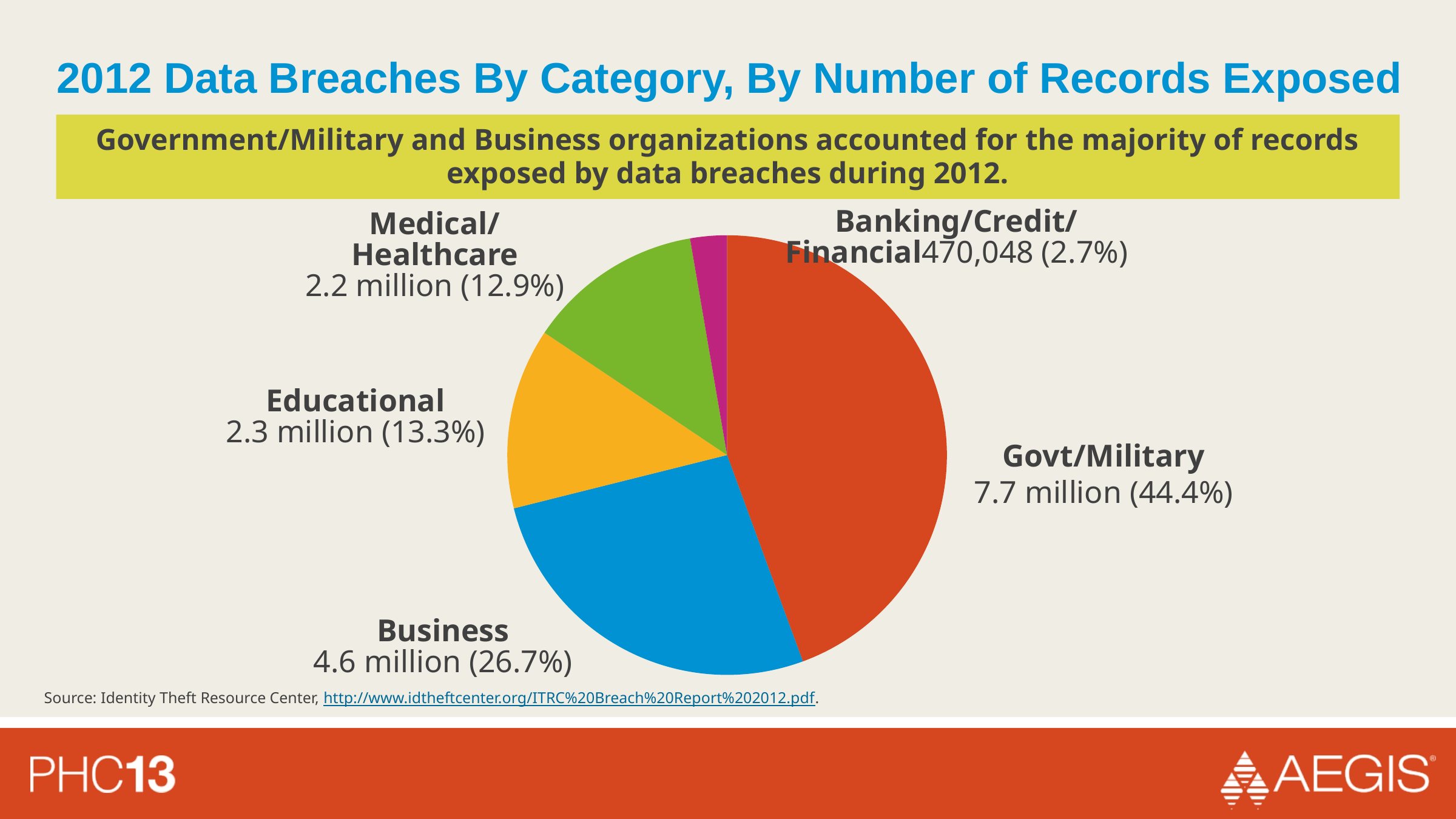
How many categories does the pie chart show? 5 What colour is the Govt/Military slice of the pie chart? Red What share of records exposed is attributed to Govt/Military? 44.4% What percentage of records exposed is attributed to Educational? 13.3% What is the difference in percentage points between the Govt/Military share and the Business share? 17.7 percentage points Which category accounts for the smallest share of records exposed? Banking/Credit/Financial What share of records exposed is attributed to Medical/Healthcare? 12.9% Which category accounts for the largest share of records exposed? Govt/Military Which category has a larger share of records exposed, Business or Educational? Business How many records were exposed in the Banking/Credit/Financial category? 470,048 How many records were exposed in the Business category? 4.6 million What kind of chart is shown on the slide? Pie chart